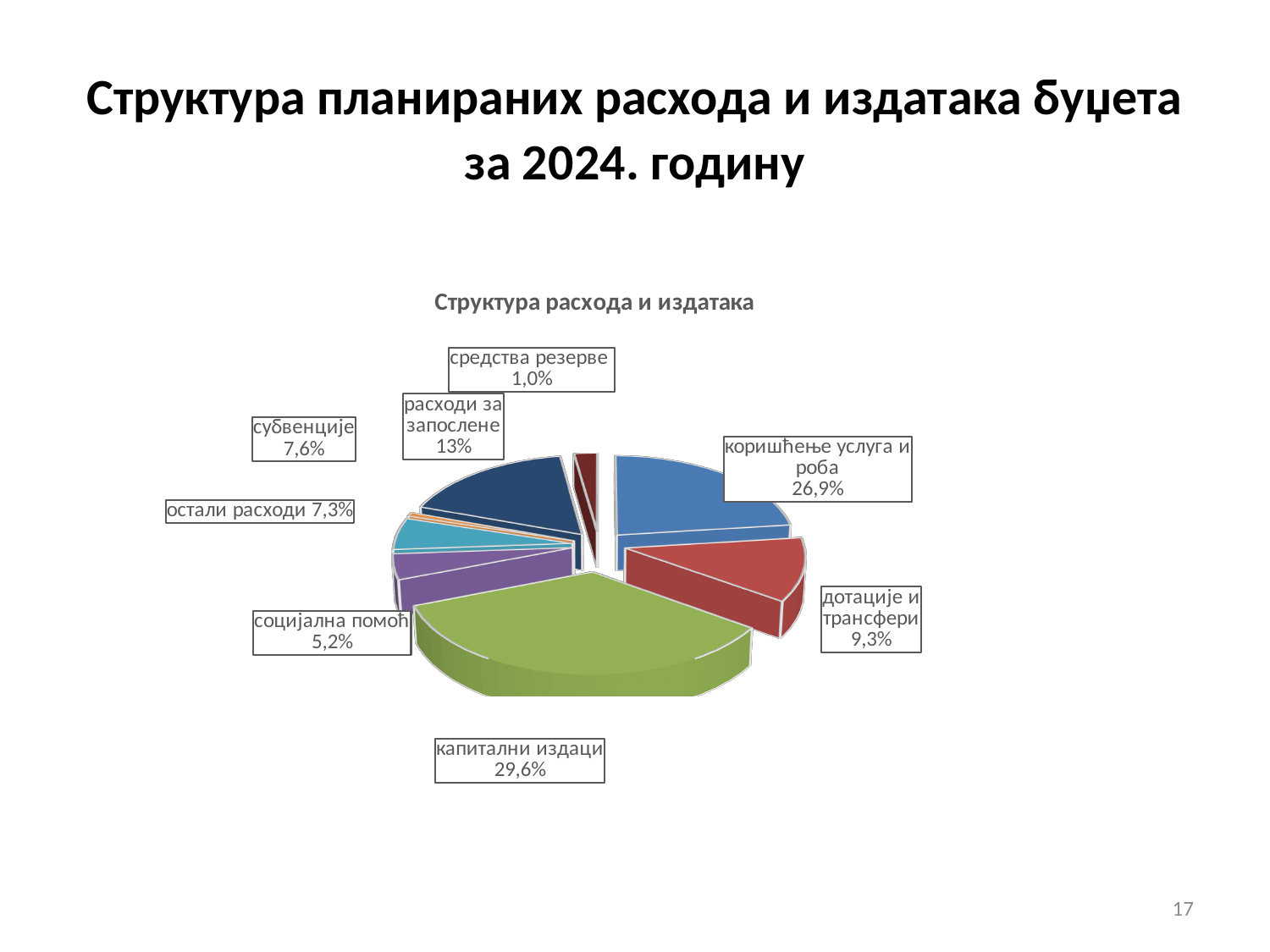
Which category has the largest share of the pie? капитални издаци What share of the pie is labelled for средства резерве? 1,0% What share of the pie is labelled for капитални издаци? 29,6% What is the difference in percentage points between капитални издаци and коришћење услуга и роба? 2,7 How many categories are labelled on the pie chart? 8 Which category has the smallest share of the pie? средства резерве Which is larger, the share for субвенције or the share for социјална помоћ? субвенције What share of the pie is labelled for расходи за запослене? 13% What share of the pie is labelled for коришћење услуга и роба? 26,9% What type of chart is shown on the slide? pie chart What is the title of the chart? Структура расхода и издатака What share of the pie is labelled for дотације и трансфери? 9,3%